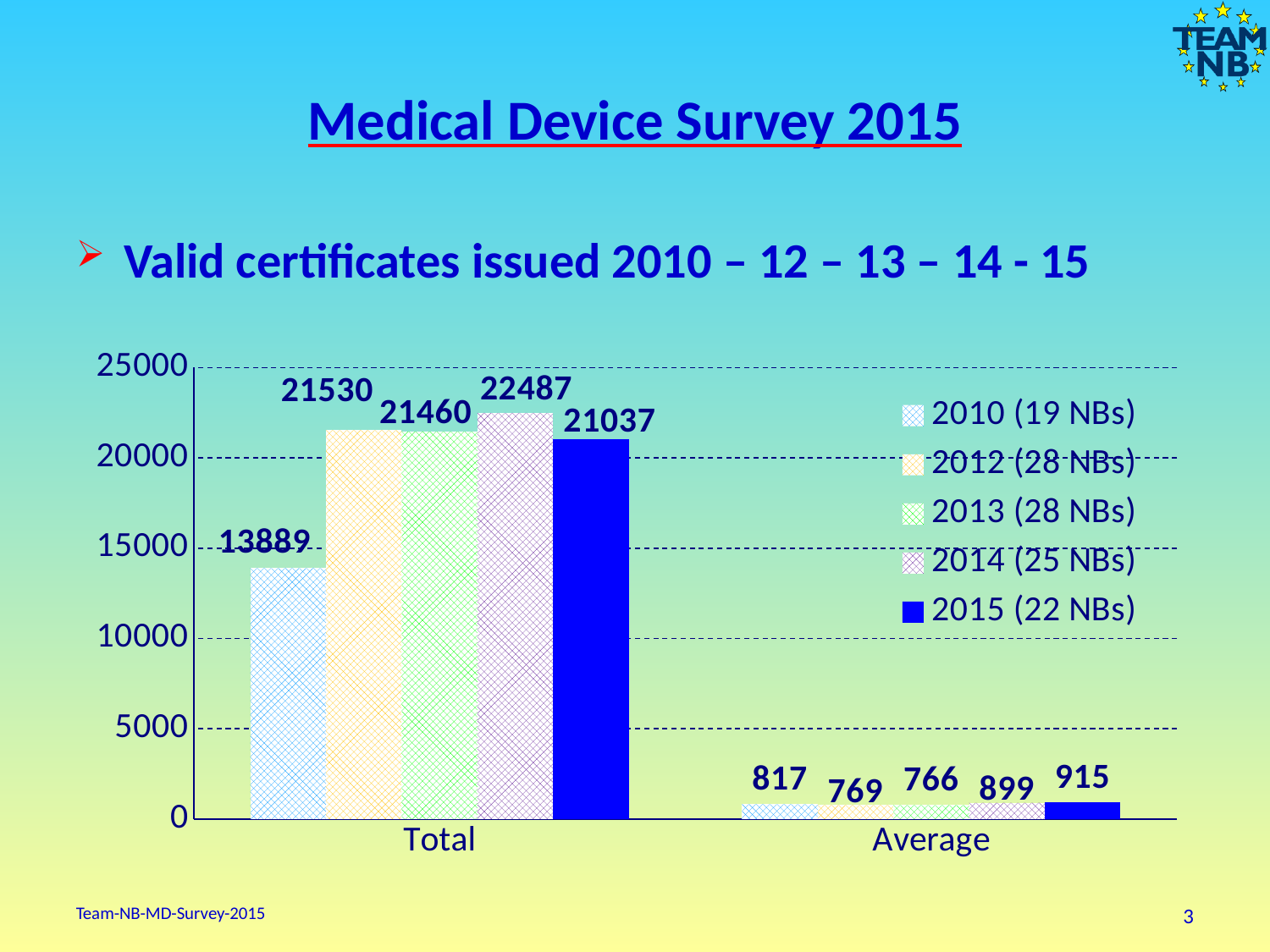
What is the Average value for 2015 (22 NBs)? 915 Is the Total value for 2010 (19 NBs) greater or less than 15000? less Which is larger, the Total value for 2012 (28 NBs) or for 2013 (28 NBs)? 2012 (28 NBs) How many series does the legend list? 5 Which series has the lowest Average value? 2013 (28 NBs) What kind of chart is shown on the slide? bar chart What is the Total value for 2014 (25 NBs)? 22487 Which series has the highest Total value? 2014 (25 NBs) What is the difference between the Average values for 2015 (22 NBs) and 2010 (19 NBs)? 98 How many categories are shown on the x axis? 2 What is the Total value for 2010 (19 NBs)? 13889 What is the difference between the Total values for 2014 (25 NBs) and 2015 (22 NBs)? 1450